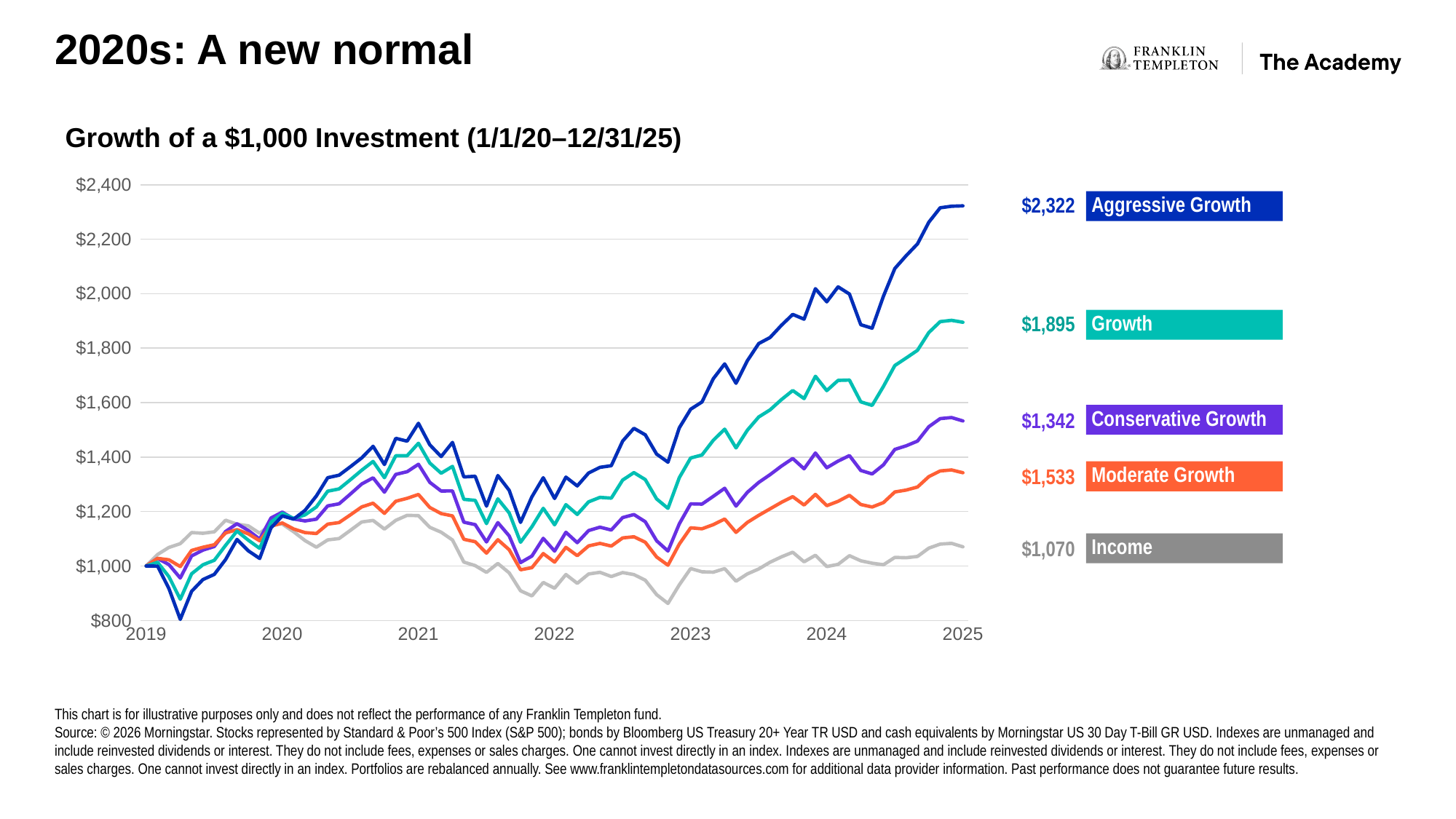
Is the value of the Aggressive Growth line at 2025 greater or less than $2,200? greater What kind of chart is shown on the slide? Line chart Which has a larger ending value, Growth or Income? Growth What is the difference between the ending values of Growth and Income? $825 How many portfolios are plotted on the chart? 5 Which portfolio has the highest ending value? Aggressive Growth What is the ending value shown for the Growth portfolio? $1,895 What is the difference between the ending values of Aggressive Growth and Growth? $427 What is the title of the chart? Growth of a $1,000 Investment (1/1/20–12/31/25) Which portfolio has the lowest ending value? Income What is the ending value shown for the Income portfolio? $1,070 What is the ending value shown for the Aggressive Growth portfolio? $2,322